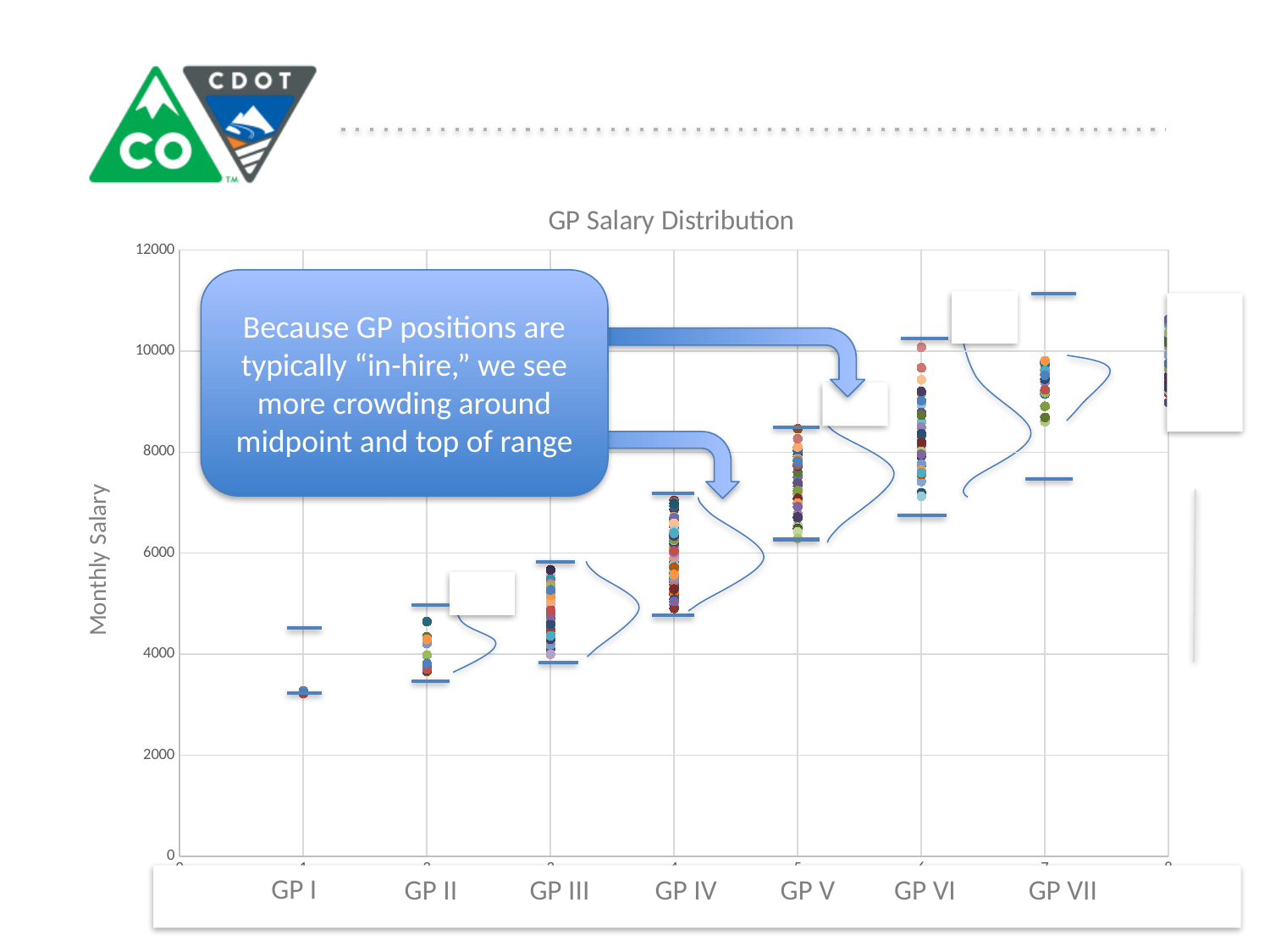
Do monthly salaries generally rise or fall moving from GP I to GP VII? Rise How many GP levels are shown along the x axis of the chart? 7 Is the bottom of the salary range for GP V greater or less than 6000? greater Which has higher monthly salaries, GP II or GP VI? GP VI What kind of chart is shown on the slide? Scatter chart Which GP level has the lowest monthly salaries in the chart? GP I Are the plotted monthly salaries for GP I greater or less than 4000? less What is the label on the vertical axis of the chart? Monthly Salary Is the top of the salary range for GP VII greater or less than 10000? greater What is the title of the chart? GP Salary Distribution Which GP level has the highest monthly salaries in the chart? GP VII